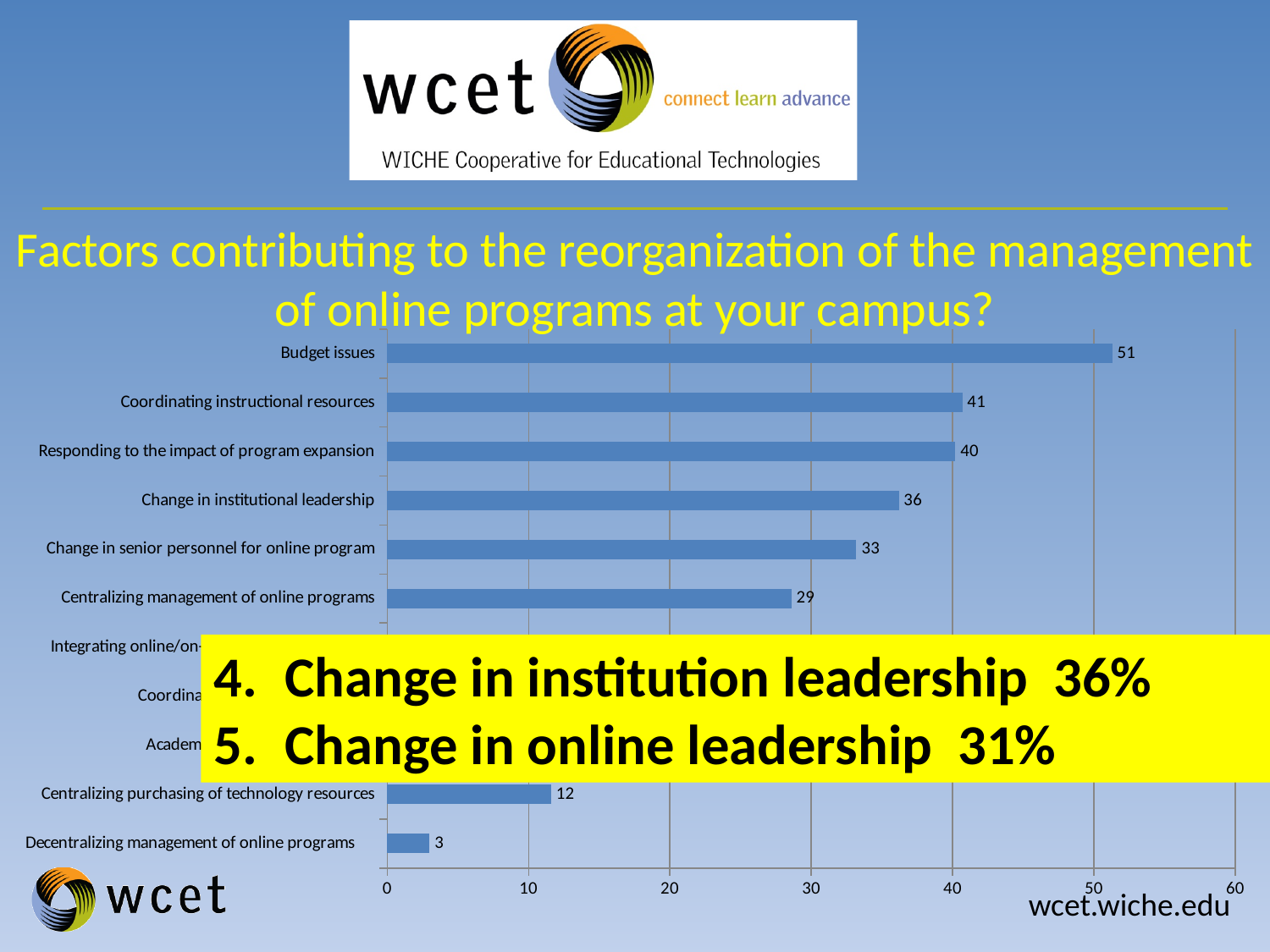
Is the value for Centralizing purchasing of technology resources greater or less than 20? less How many categories are plotted in the chart? 11 What value is shown for Budget issues? 51 What value is shown for Decentralizing management of online programs? 3 Which is larger: the value for Responding to the impact of program expansion or the value for Centralizing management of online programs? Responding to the impact of program expansion Which category has the lowest value? Decentralizing management of online programs What value is shown for Coordinating instructional resources? 41 What value is shown for Change in senior personnel for online program? 33 What kind of chart is shown on the slide? bar chart Which category has the highest value? Budget issues What is the difference between the values for Budget issues and Change in institutional leadership? 15 What is the maximum value shown on the horizontal axis? 60